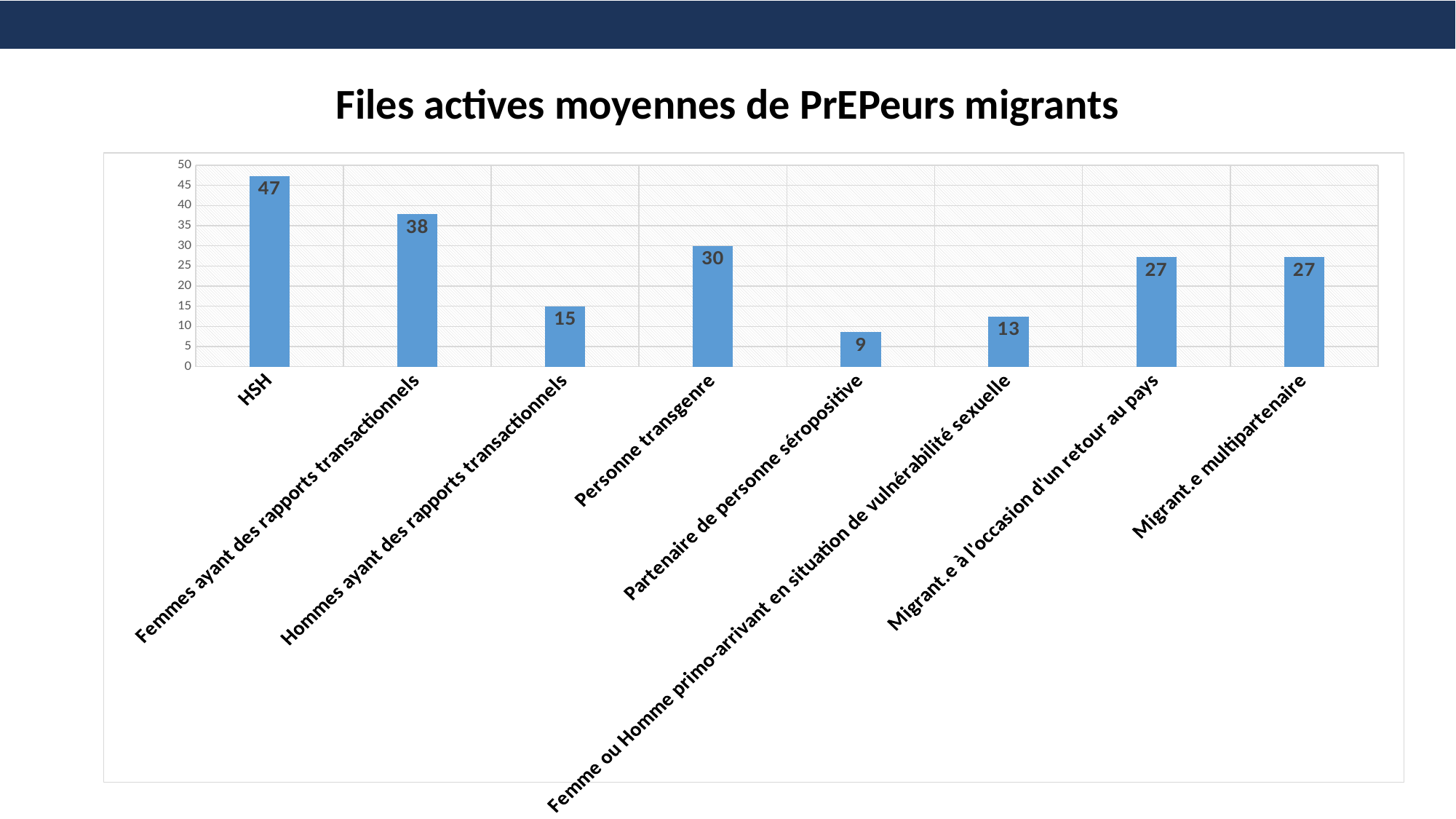
What is the value for Femme ou Homme primo-arrivant en situation de vulnérabilité sexuelle? 13 What is the value for HSH? 47 Which is larger, the value for Personne transgenre or the value for Migrant.e multipartenaire? Personne transgenre What is the title of the chart? Files actives moyennes de PrEPeurs migrants Is the value for Femmes ayant des rapports transactionnels greater or less than 35? greater How many categories are shown on the chart? 8 Which category has the highest value? HSH What is the difference between the values for Femmes ayant des rapports transactionnels and Hommes ayant des rapports transactionnels? 23 What is the value for Personne transgenre? 30 What is the value for Partenaire de personne séropositive? 9 What kind of chart is shown on the slide? Bar chart Which category has the lowest value? Partenaire de personne séropositive